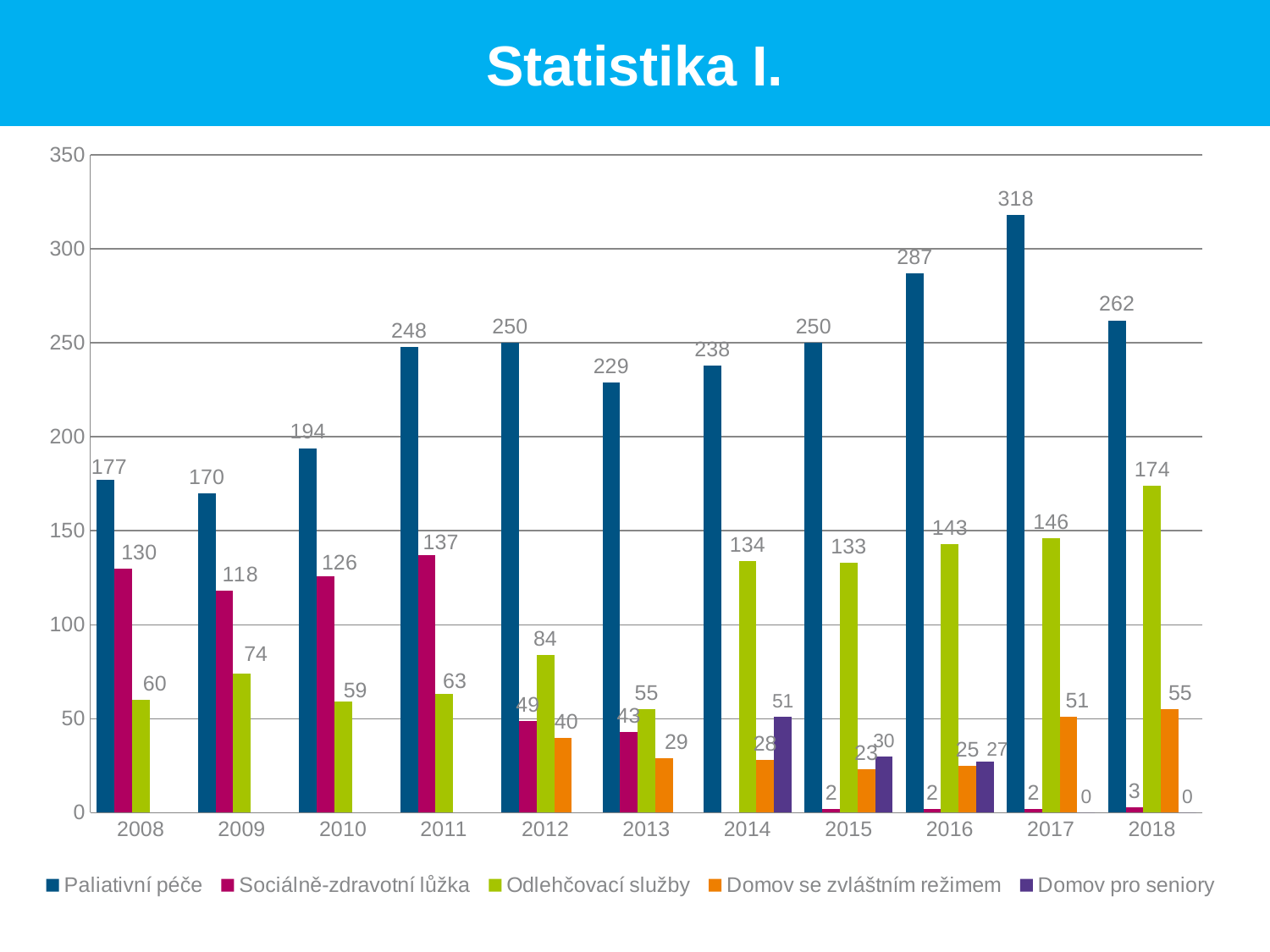
What is the title of the slide? Statistika I. What is the value for Paliativní péče in 2017? 318 In which year is Paliativní péče lowest? 2009 How many series does the legend list? 5 In which year is Paliativní péče highest? 2017 What is the difference between Paliativní péče in 2017 and in 2018? 56 What is the value for Domov se zvláštním režimem in 2013? 29 What is the value for Sociálně-zdravotní lůžka in 2011? 137 Which is larger, Odlehčovací služby in 2016 or Odlehčovací služby in 2017? Odlehčovací služby in 2017 How many years are shown on the x axis? 11 What is the value for Odlehčovací služby in 2018? 174 What kind of chart is shown on the slide? Bar chart